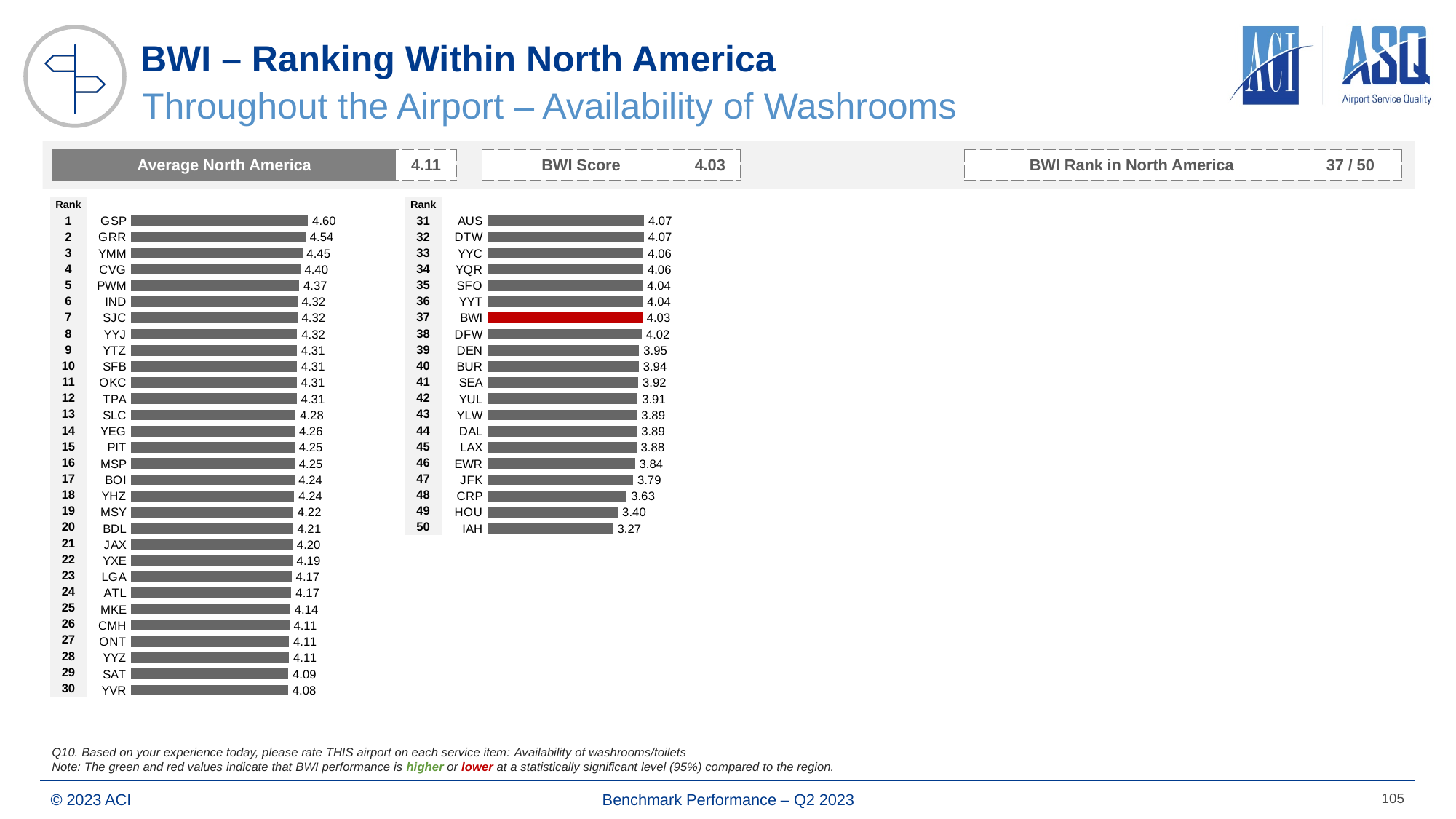
What kind of chart is used to show the airport scores on this slide? Bar chart On the right chart (ranks 31-50), what is the value for BWI? 4.03 How many airports are plotted on the right chart (ranks 31-50)? 20 On the left chart (ranks 1-30), what is the value for GSP? 4.60 On the left chart (ranks 1-30), which airport has the highest value? GSP On the left chart (ranks 1-30), which is larger, the value for CVG or the value for PWM? CVG On the right chart (ranks 31-50), which is larger, the value for JFK or the value for CRP? JFK How many airports are plotted on the left chart (ranks 1-30)? 30 On the right chart (ranks 31-50), what is the difference between the values for BWI and IAH? 0.76 On the right chart (ranks 31-50), which airport's bar is highlighted in red? BWI On the left chart (ranks 1-30), what is the difference between the values for GSP and YVR? 0.52 On the right chart (ranks 31-50), which airport has the lowest value? IAH